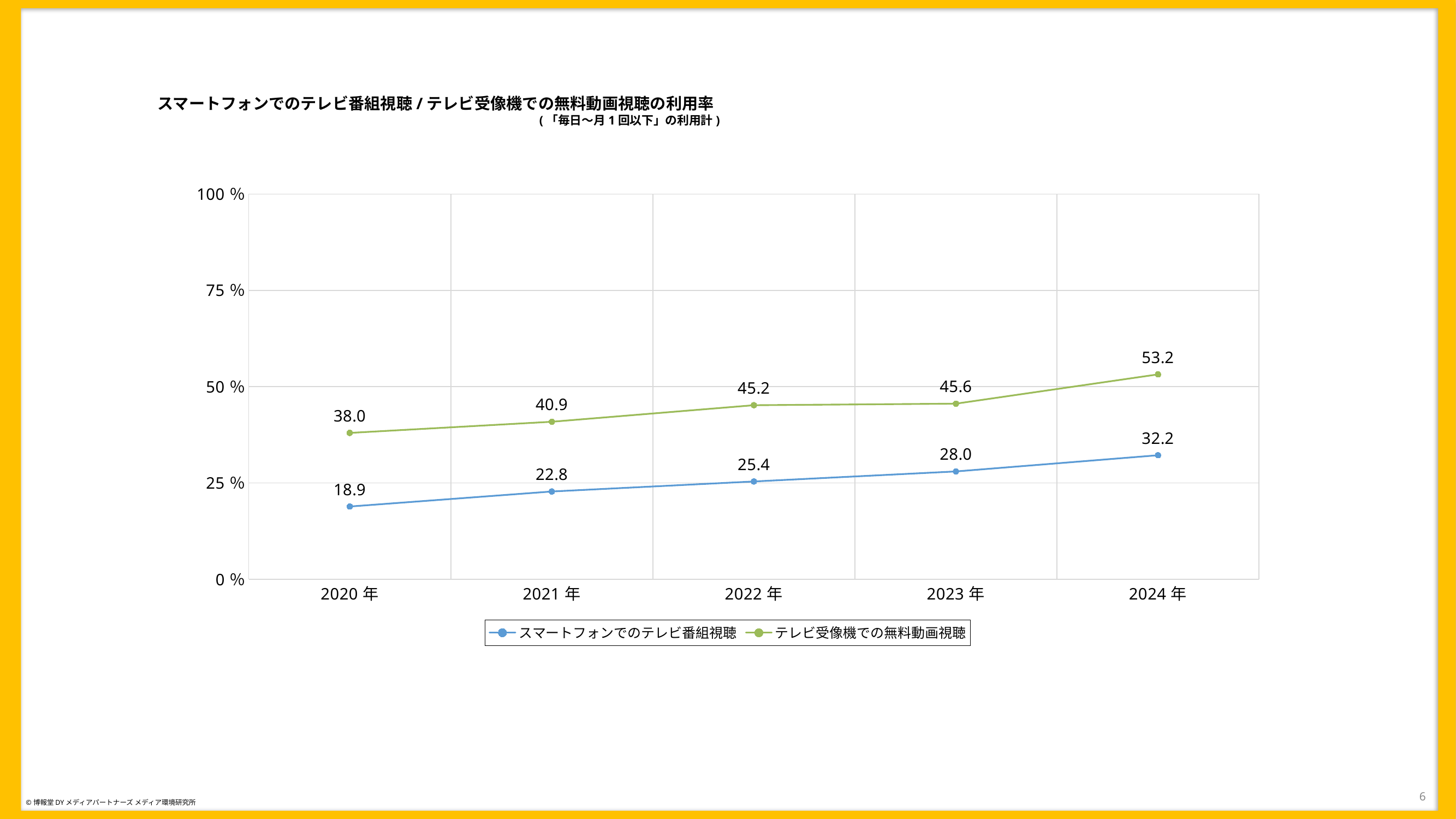
What is the value for テレビ受像機での無料動画視聴 in 2022年? 45.2 What kind of chart is shown on the slide? line chart What is the difference between テレビ受像機での無料動画視聴 and スマートフォンでのテレビ番組視聴 in 2024年? 21.0 How many series does the legend list? 2 In which year is テレビ受像機での無料動画視聴 lowest? 2020年 What is the value for スマートフォンでのテレビ番組視聴 in 2023年? 28.0 What is the value for スマートフォンでのテレビ番組視聴 in 2020年? 18.9 What is the value for テレビ受像機での無料動画視聴 in 2024年? 53.2 In which year is スマートフォンでのテレビ番組視聴 highest? 2024年 Which series has the larger value in 2021年, スマートフォンでのテレビ番組視聴 or テレビ受像機での無料動画視聴? テレビ受像機での無料動画視聴 Is the value for テレビ受像機での無料動画視聴 in 2024年 greater or less than 50%? greater How many years are shown on the x axis? 5